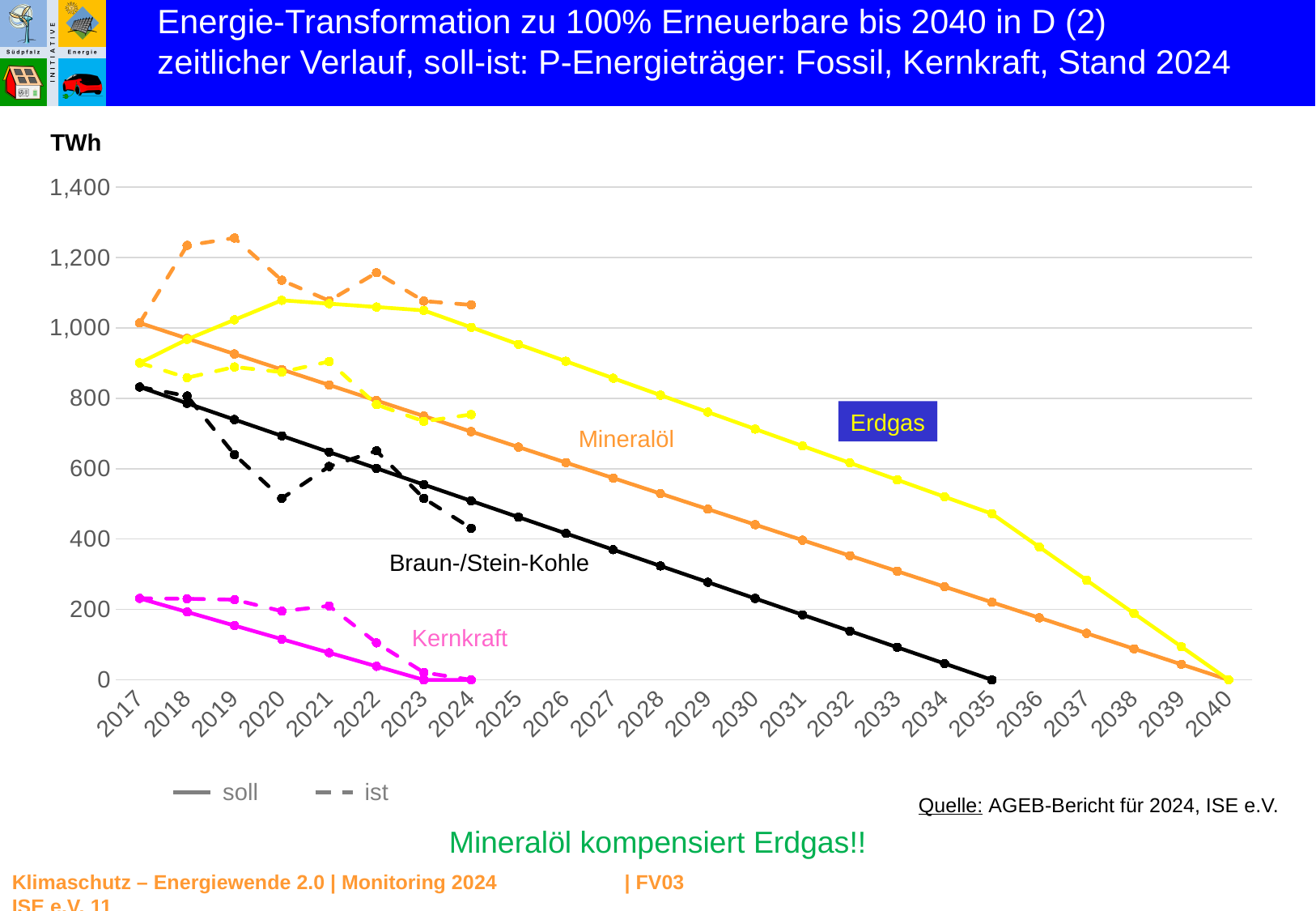
What kind of chart is shown on the slide? line chart How many entries does the legend below the chart list? 2 Is the Braun-/Stein-Kohle soll value for 2017 greater or less than 800? greater What value does the Braun-/Stein-Kohle soll line reach in 2035? 0 Does the Mineralöl soll line rise or fall from 2017 to 2040? fall What value does the Erdgas soll line reach in 2040? 0 What colour is the Erdgas line in the chart? yellow In 2030, which soll line is higher: Erdgas or Mineralöl? Erdgas Is the Kernkraft soll value for 2021 greater or less than 200? less How many years are shown on the x axis of the chart? 24 What are the two legend entries below the chart? soll, ist Is the Erdgas ist value for 2019 greater or less than 1,200? less